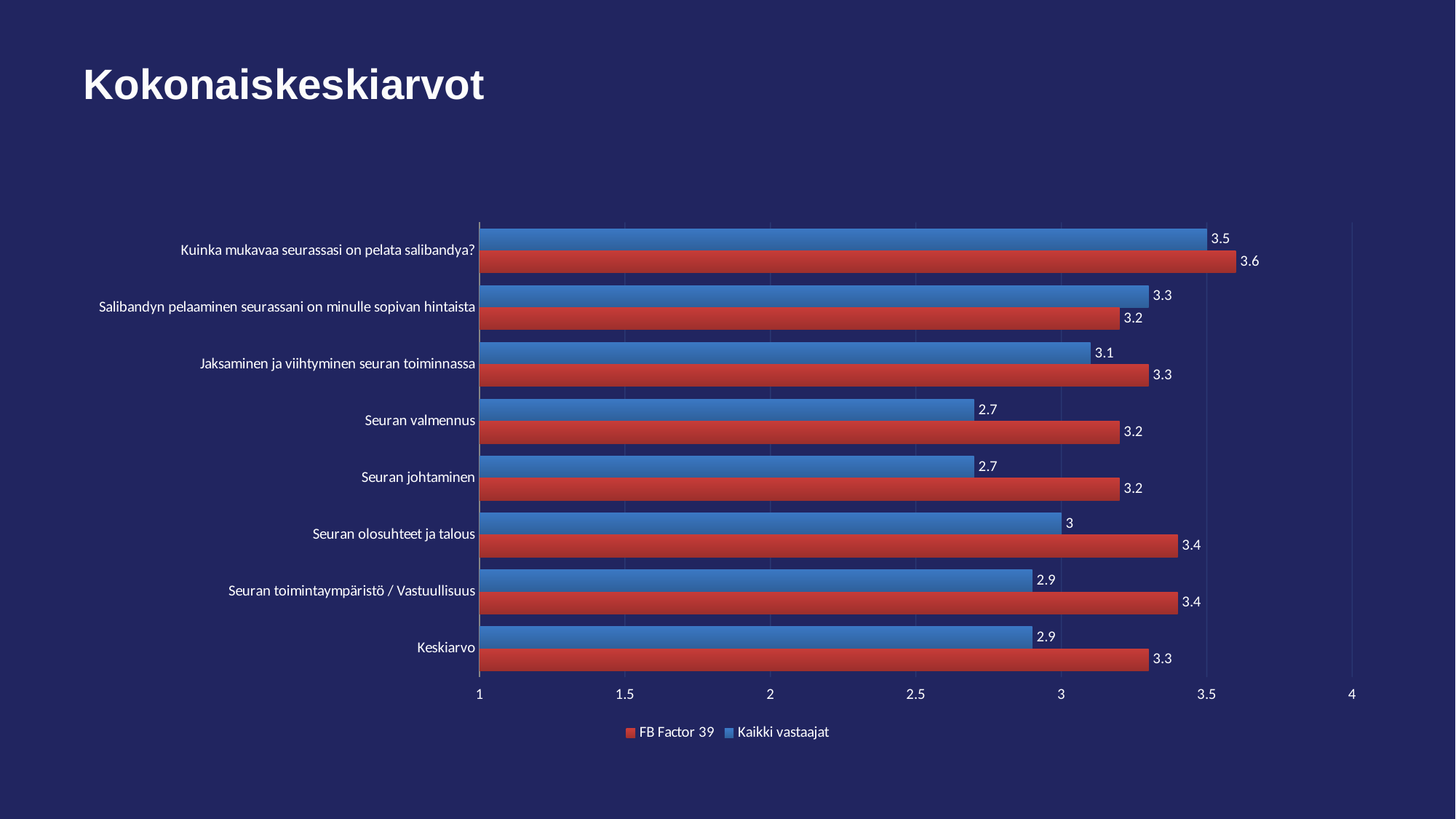
What is the title of the slide? Kokonaiskeskiarvot What is the FB Factor 39 value for "Seuran valmennus"? 3.2 Is the Kaikki vastaajat value for "Seuran toimintaympäristö / Vastuullisuus" greater or less than 3? less What is the difference between the FB Factor 39 and Kaikki vastaajat values for "Seuran johtaminen"? 0.5 How many series does the legend list? 2 What kind of chart is shown on the slide? Bar chart How many categories are shown on the chart? 8 What is the Kaikki vastaajat value for "Seuran olosuhteet ja talous"? 3 What is the Kaikki vastaajat value for "Keskiarvo"? 2.9 For "Salibandyn pelaaminen seurassani on minulle sopivan hintaista", which series has the larger value, FB Factor 39 or Kaikki vastaajat? Kaikki vastaajat Which category has the highest Kaikki vastaajat value? Kuinka mukavaa seurassasi on pelata salibandya? Which category has the highest FB Factor 39 value? Kuinka mukavaa seurassasi on pelata salibandya?